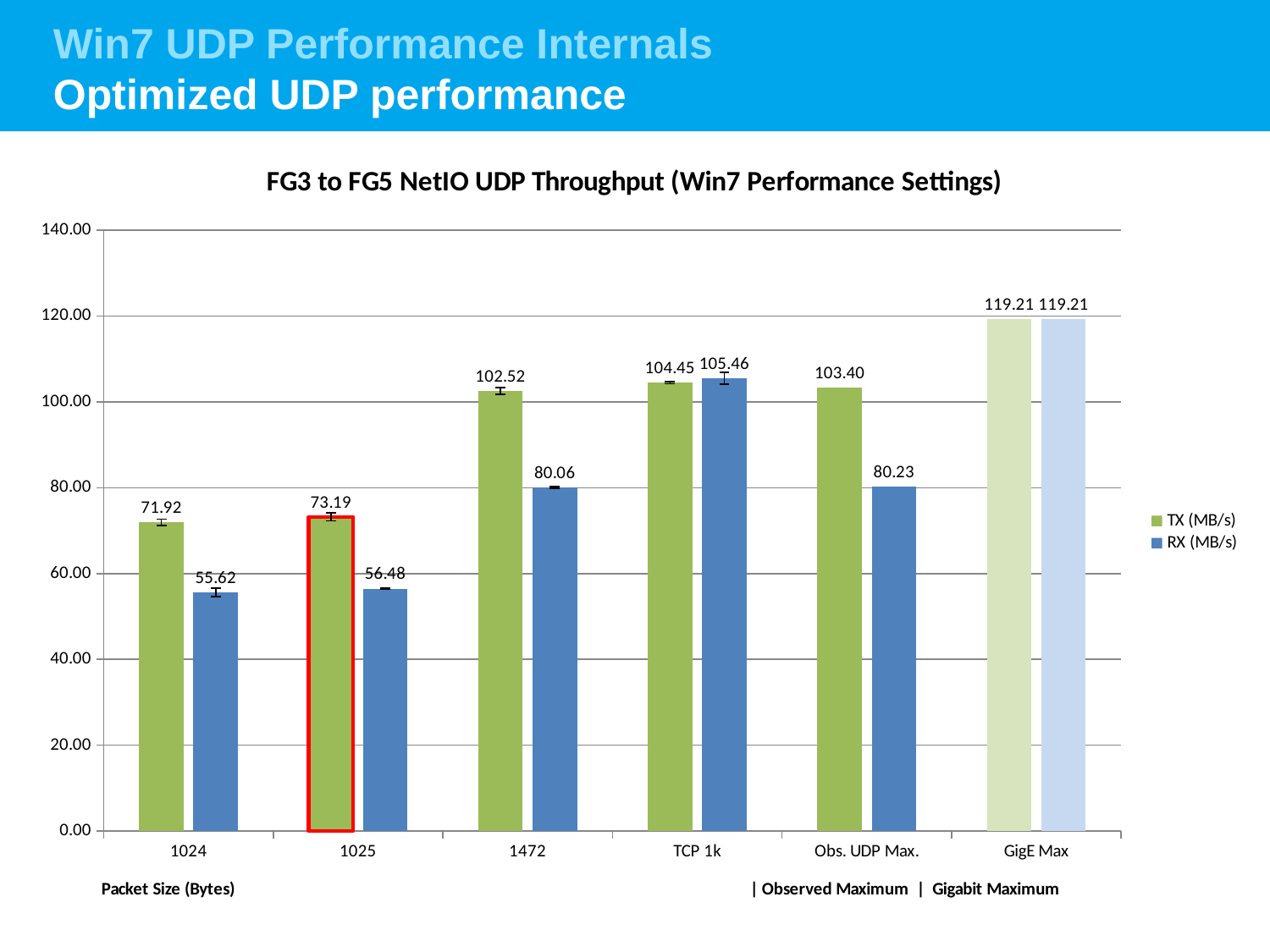
What is the RX (MB/s) value for packet size 1024? 55.62 What is the difference between the TX (MB/s) and RX (MB/s) values for packet size 1472? 22.46 How many series does the legend list? 2 What kind of chart is shown on the slide? Bar chart How many categories are shown on the x axis? 6 Which category has the lowest RX (MB/s) value? 1024 For TCP 1k, which is larger, the TX (MB/s) value or the RX (MB/s) value? RX (MB/s) What is the difference between the TX (MB/s) values for packet sizes 1025 and 1024? 1.27 Which category has the highest TX (MB/s) value? GigE Max What is the TX (MB/s) value for packet size 1472? 102.52 What is the RX (MB/s) value for TCP 1k? 105.46 What is the TX (MB/s) value for Obs. UDP Max.? 103.40